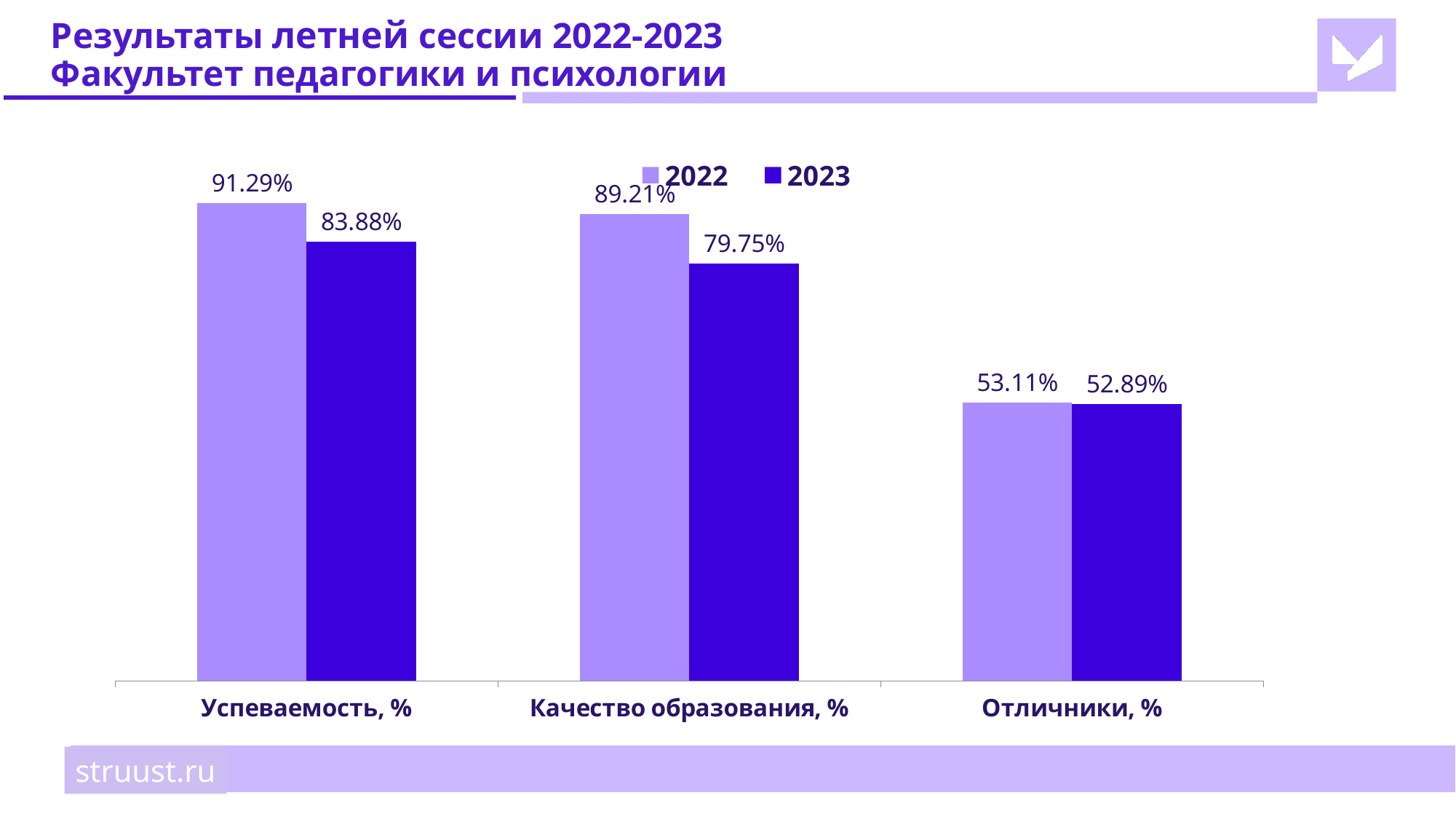
What is the value for Успеваемость, % in 2022? 91.29% What is the difference between the 2022 and 2023 values for Успеваемость, %? 7.41% What is the value for Качество образования, % in 2023? 79.75% Which is larger for Качество образования, %: the 2022 value or the 2023 value? 2022 How many series does the legend list? 2 What is the value for Отличники, % in 2022? 53.11% Which category has the highest value for the 2022 series? Успеваемость, % What is the difference between the 2022 and 2023 values for Качество образования, %? 9.46% What is the value for Отличники, % in 2023? 52.89% What kind of chart is shown on the slide? Bar chart Which category has the lowest value for the 2023 series? Отличники, % How many categories are shown on the x axis? 3